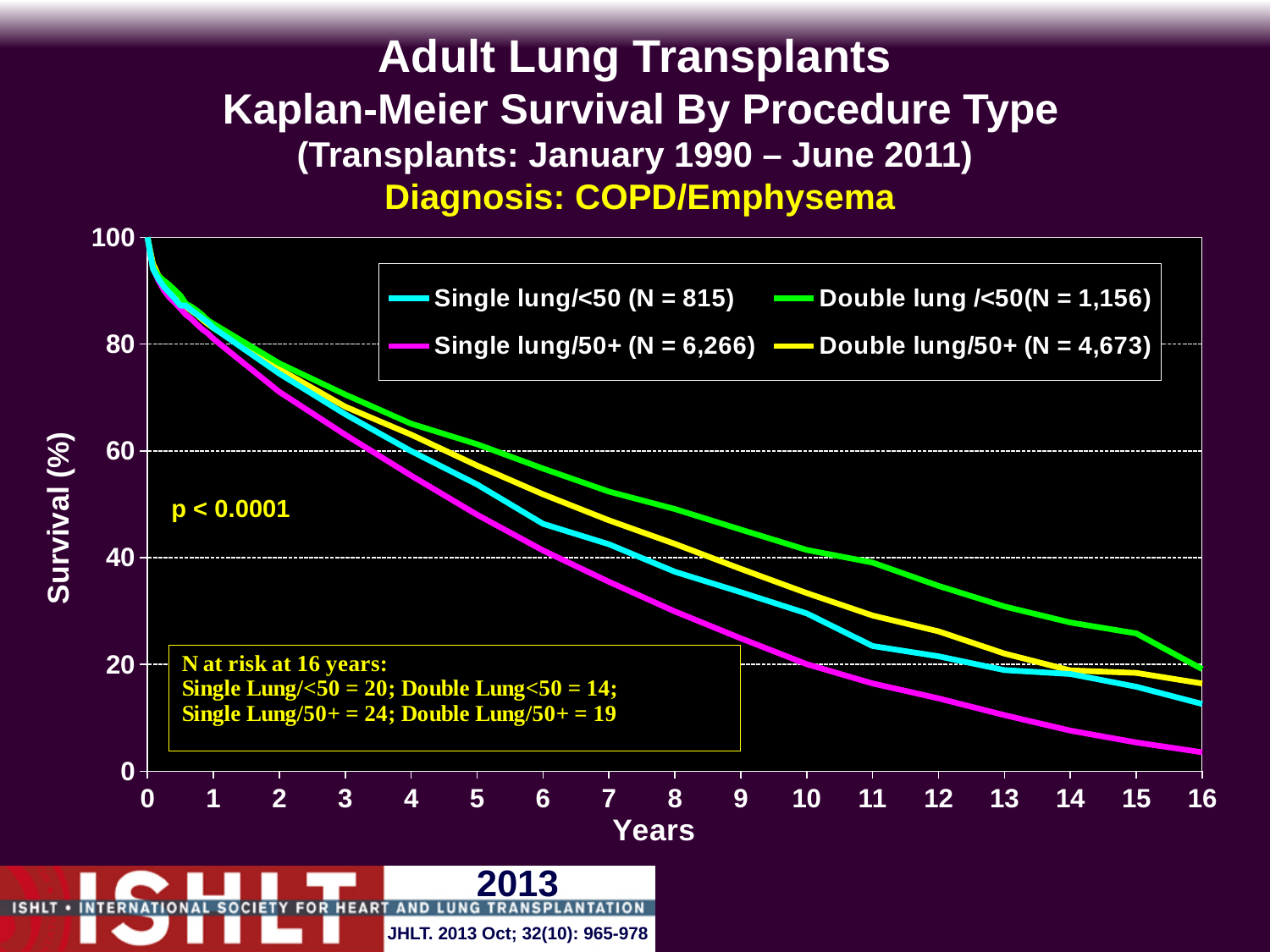
What is the N at risk at 16 years for Single Lung/50+? 24 What kind of chart is shown on the slide? line chart What is the N for the Single lung/50+ series shown in the legend? 6,266 Is the survival for Double lung /<50 at 4 years greater or less than 60? greater Is the survival for Single lung/50+ at 4 years greater or less than 60? less Is the survival for Single lung/<50 at 16 years greater or less than 20? less At 10 years, which series has higher survival: Double lung /<50 or Single lung/50+? Double lung /<50 Do the survival curves rise or fall as years increase? fall Which series has the lowest survival at 16 years? Single lung/50+ How many series does the legend list? 4